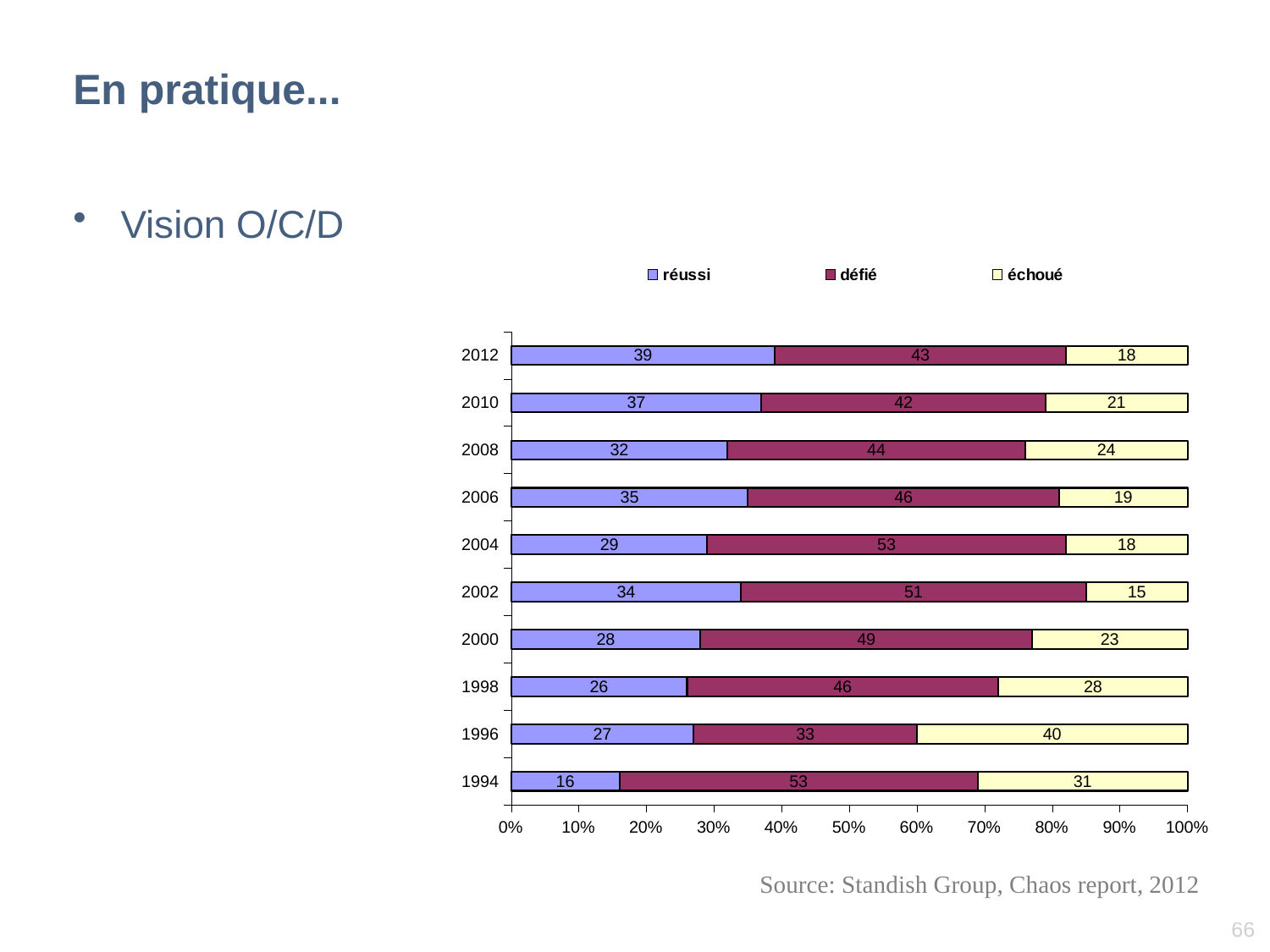
Which series is shown in yellow in the legend? échoué Which is larger, the 'défié' value for 2004 or for 2006? 2004 What is the value for 'défié' in 1994? 53 What is the difference between the 'réussi' values for 2012 and 1994? 23 Which year has the highest 'échoué' value? 1996 How many series does the legend list? 3 What kind of chart is shown on the slide? Stacked bar chart What is the total of the stacked bar for 2010? 100 How many years are shown on the chart? 10 Which year has the lowest 'réussi' value? 1994 What is the value for 'réussi' in 2012? 39 What is the value for 'échoué' in 1996? 40